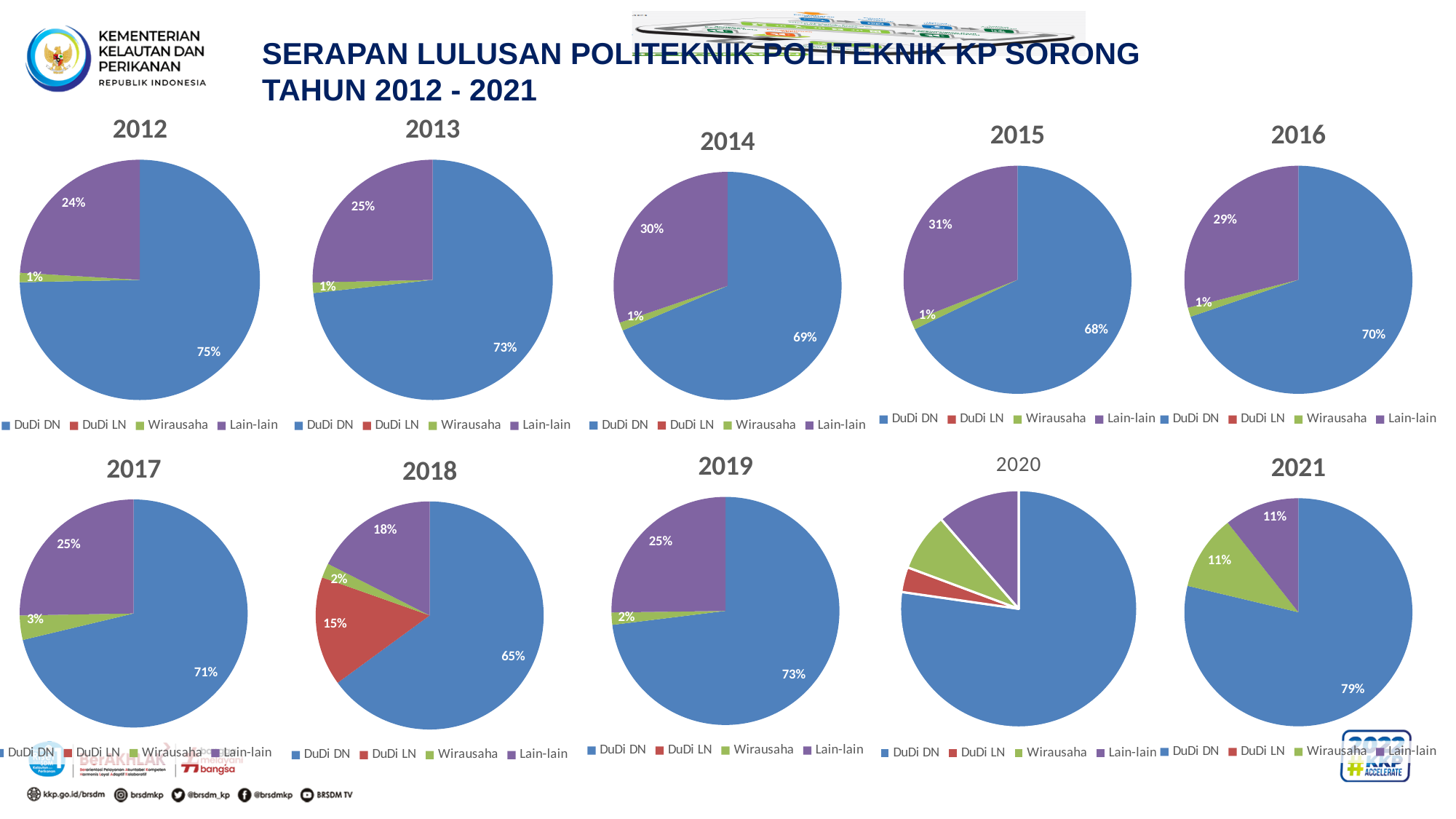
In the 2012 pie chart, what percentage is shown for DuDi DN? 75% In the 2021 pie chart, what percentage is shown for Wirausaha? 11% Is the DuDi DN share larger in the 2021 pie chart or the 2012 pie chart? 2021 In the 2019 pie chart, what percentage is shown for Wirausaha? 2% In the 2017 pie chart, which is larger, Lain-lain or Wirausaha? Lain-lain How many pie charts are shown on the slide? 10 In the 2014 pie chart, what is the difference between the DuDi DN share and the Lain-lain share? 39% In the 2016 pie chart, what percentage is shown for Lain-lain? 29% In the 2018 pie chart, what percentage is shown for DuDi LN? 15% What type of chart is used for each year on the slide? Pie chart In the 2015 pie chart, which category has the largest slice? DuDi DN How many entries does the legend of the 2013 pie chart list? 4